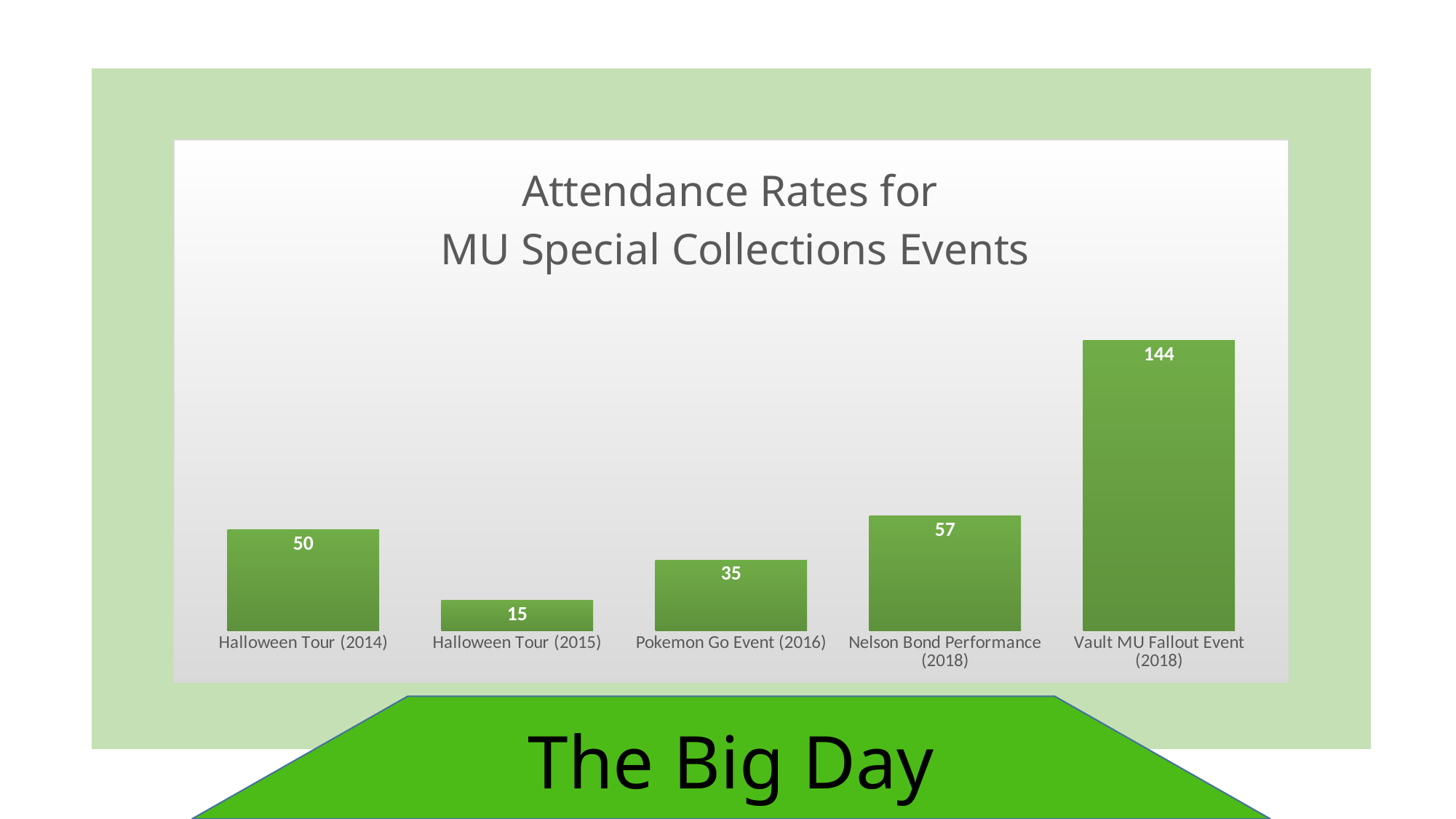
What is the attendance for the Pokemon Go Event (2016)? 35 What is the title of the chart? Attendance Rates for MU Special Collections Events What is the difference in attendance between the Vault MU Fallout Event (2018) and the Nelson Bond Performance (2018)? 87 Which event had the highest attendance? Vault MU Fallout Event (2018) What is the attendance for the Halloween Tour (2015)? 15 What is the attendance for the Halloween Tour (2014)? 50 Which event had the lowest attendance? Halloween Tour (2015) How many events are shown in the chart? 5 Which had higher attendance, the Halloween Tour (2014) or the Pokemon Go Event (2016)? Halloween Tour (2014) What is the attendance for the Nelson Bond Performance (2018)? 57 What kind of chart is shown on the slide? Bar chart What is the attendance for the Vault MU Fallout Event (2018)? 144